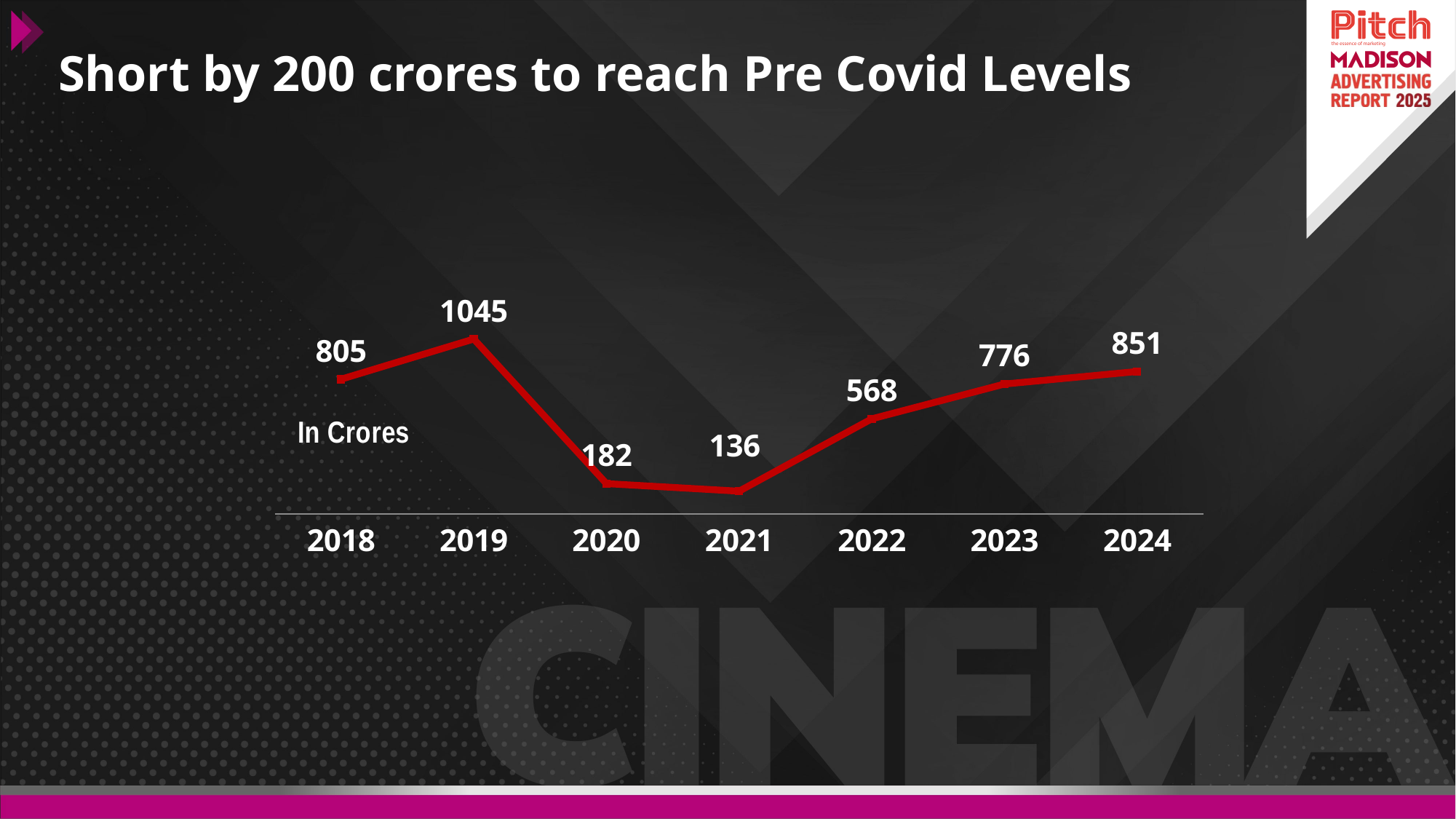
Which year has the highest value? 2019 What is the difference between the values for 2019 and 2024? 194 What is the value for 2021? 136 What is the value for 2019? 1045 Which is larger, the value for 2018 or the value for 2024? 2024 What kind of chart is shown on the slide? Line chart Which year has the lowest value? 2021 What is the value for 2024? 851 What is the difference between the values for 2023 and 2022? 208 Do the values rise or fall from 2021 to 2024? Rise How many years are plotted on the chart? 7 What unit are the values on the chart expressed in? Crores